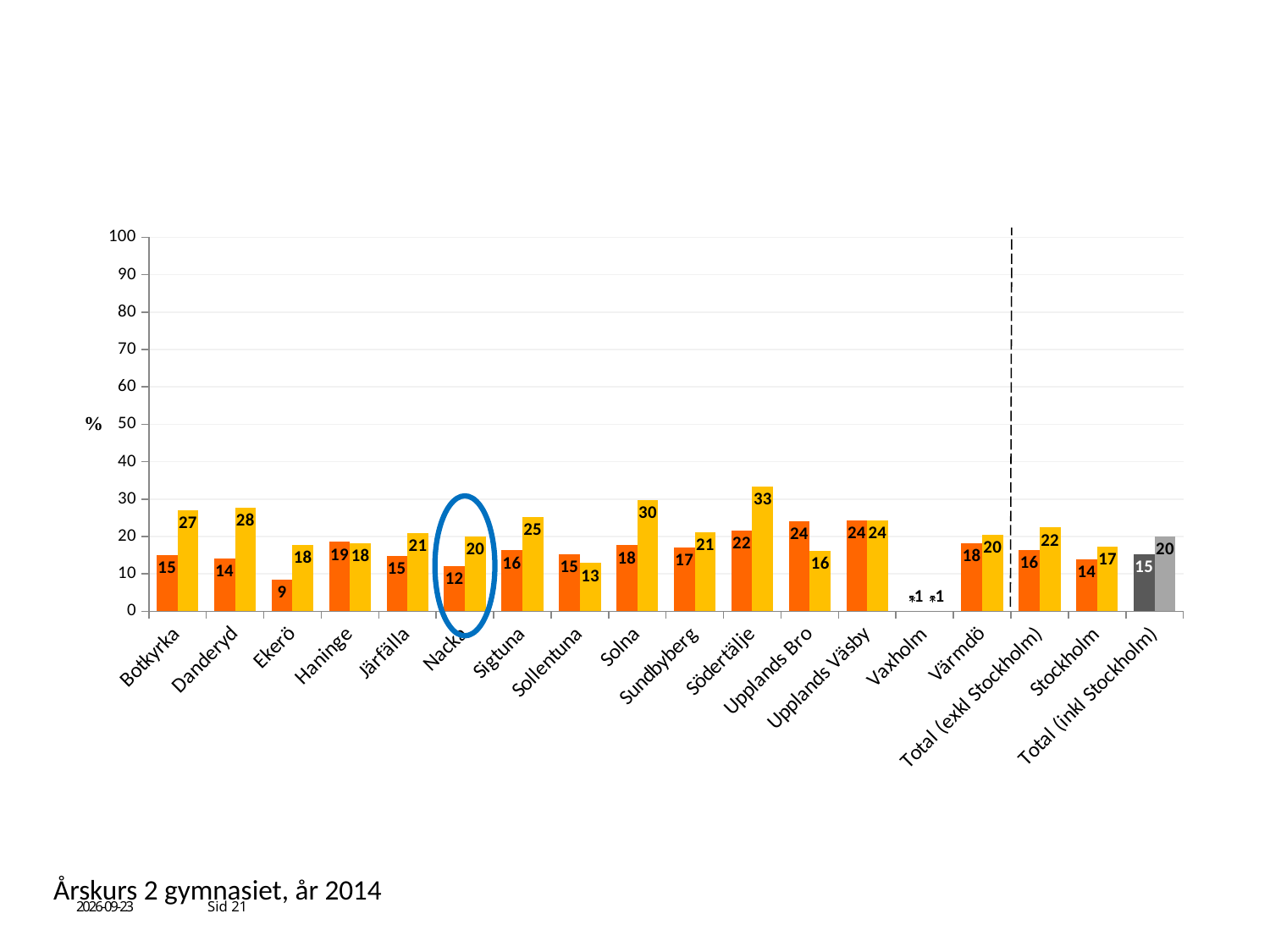
What is the value of the orange bar for Stockholm? 14 For Upplands Bro, which bar is larger, the orange or the yellow? orange Is the yellow bar for Danderyd greater or less than 20? greater What kind of chart is shown on the slide? bar chart How many categories are shown on the x axis? 18 Which municipality has the highest yellow bar? Södertälje What is the value of the yellow bar for Södertälje? 33 What label is shown on the y axis? % What is the difference between the yellow and orange bars for Solna? 12 Among the municipalities with plotted bars, which has the lowest orange bar? Ekerö What is the value of the orange bar for Nacka? 12